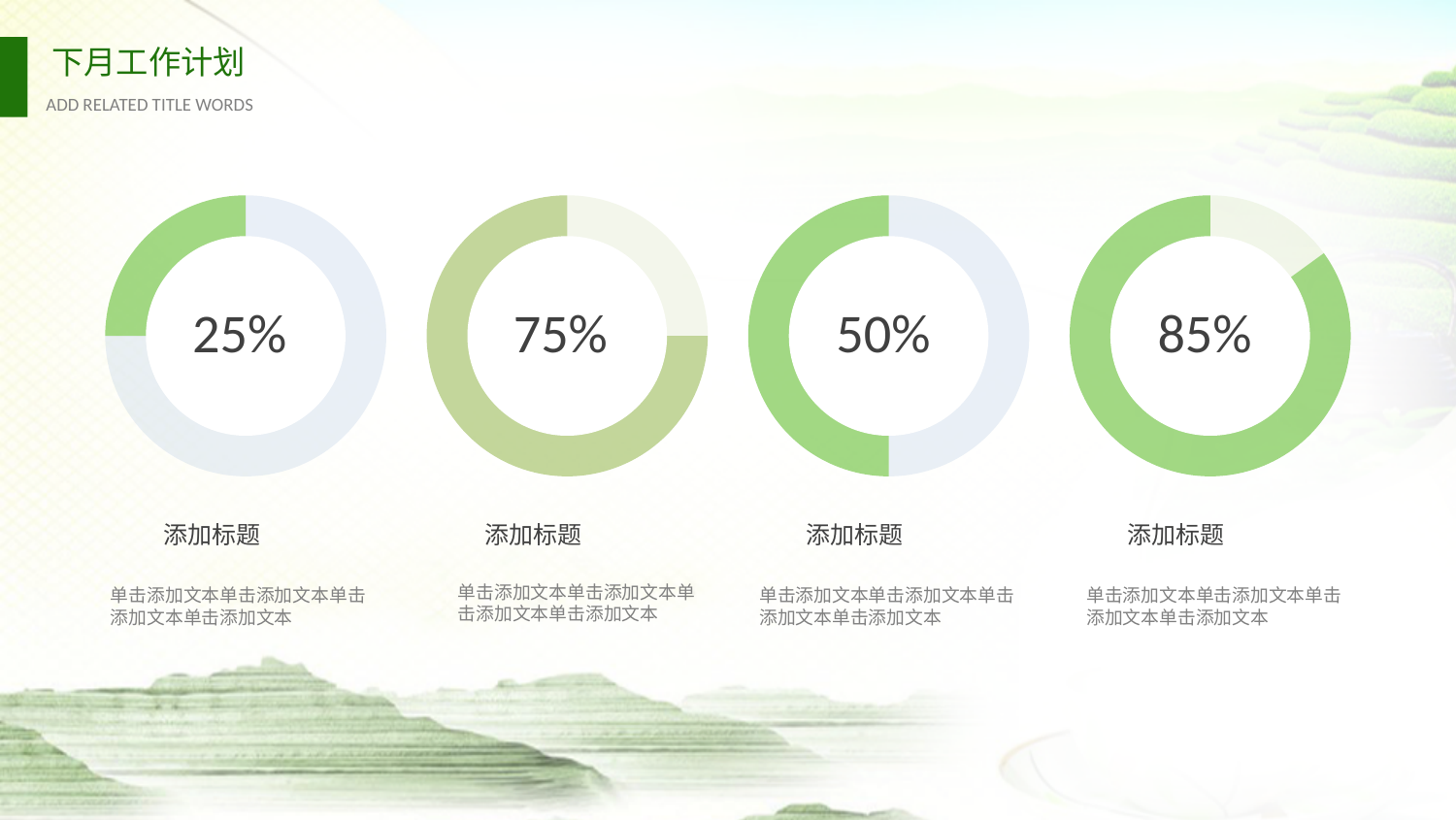
Which donut chart shows the highest percentage? The rightmost one (85%) What is the difference between the percentages in the second and third donut charts from the left? 25% What kind of chart is used to display the percentages on this slide? Donut chart What value is shown in the center of the leftmost donut chart? 25% What is the title of the slide? 下月工作计划 Which is larger: the percentage in the second donut chart from the left or the percentage in the third donut chart from the left? The second from the left (75%) How many donut charts are on the slide? 4 Which donut chart shows the lowest percentage? The leftmost one (25%) What value is shown in the center of the second donut chart from the left? 75% What is the difference between the percentage in the rightmost donut chart and the percentage in the leftmost donut chart? 60% What value is shown in the center of the third donut chart from the left? 50% What value is shown in the center of the rightmost donut chart? 85%